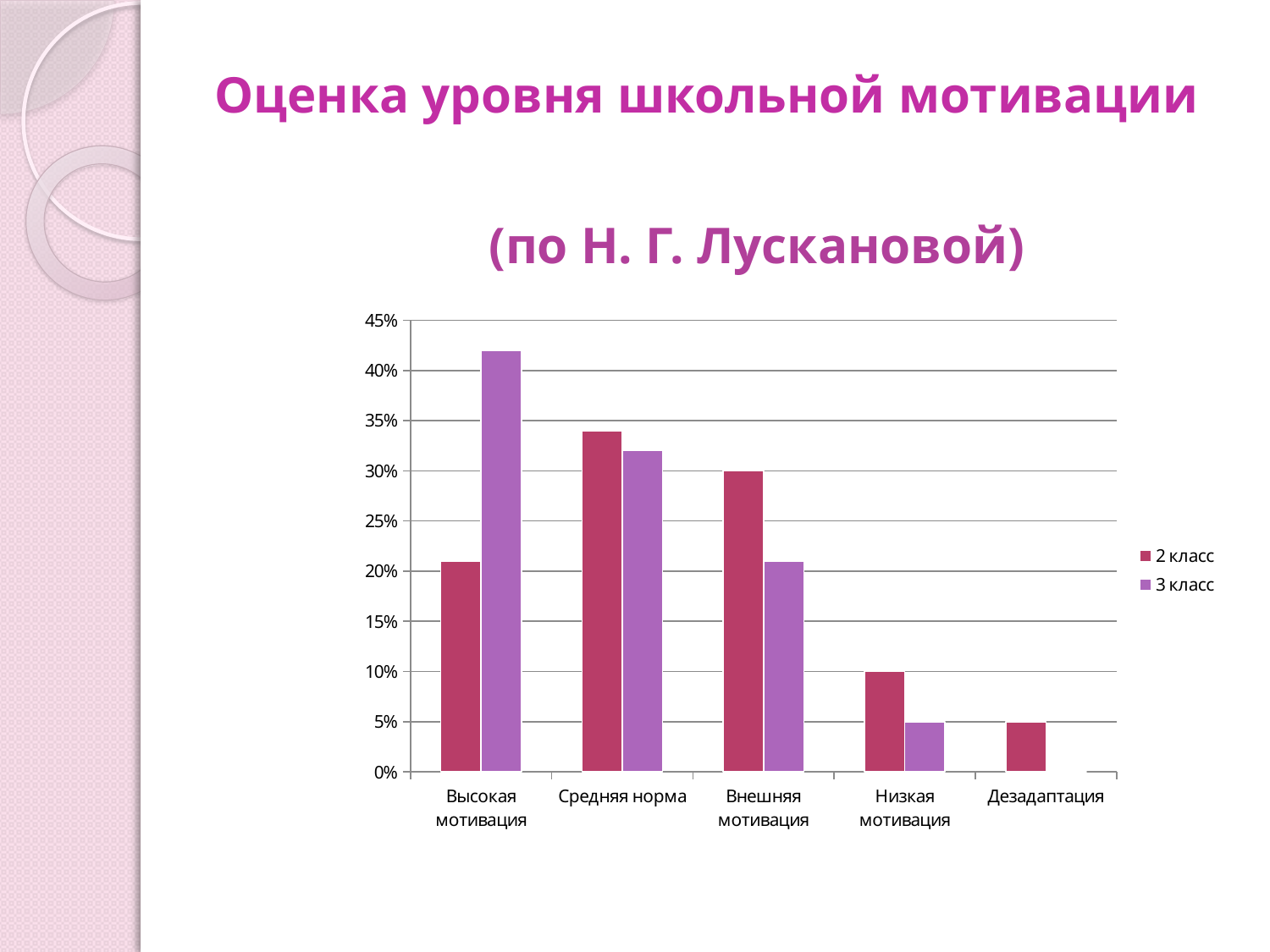
What kind of chart is shown on the slide? bar chart Which category has the highest value for 3 класс? Высокая мотивация Which category has the highest value for 2 класс? Средняя норма What is the value for 3 класс in the Низкая мотивация category? 5% What is the value for 2 класс in the Низкая мотивация category? 10% Is the value for 3 класс in the Высокая мотивация category greater or less than 40%? greater How many series does the legend list? 2 In the Высокая мотивация category, which series has the larger value, 2 класс or 3 класс? 3 класс What is the value for 2 класс in the Внешняя мотивация category? 30% Is the value for 2 класс in the Высокая мотивация category greater or less than 25%? less How many categories are shown on the x axis? 5 What is the value for 2 класс in the Дезадаптация category? 5%